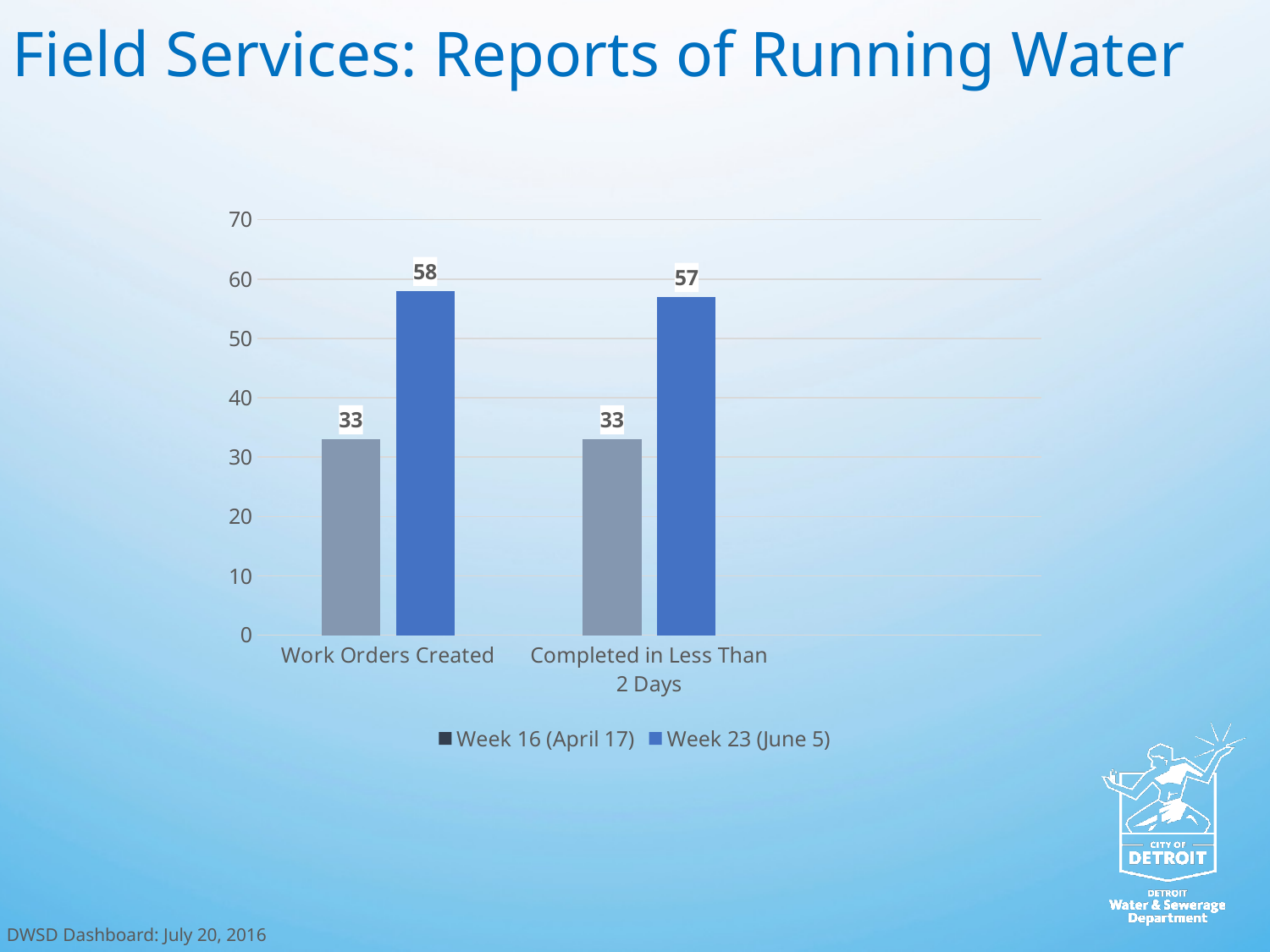
What is the value for Work Orders Created in Week 16 (April 17)? 33 Which series has the higher value for Work Orders Created, Week 16 (April 17) or Week 23 (June 5)? Week 23 (June 5) How many series does the legend list? 2 What is the value for Work Orders Created in Week 23 (June 5)? 58 What is the title of the slide? Field Services: Reports of Running Water What is the difference between the Week 23 (June 5) and Week 16 (April 17) values for Completed in Less Than 2 Days? 24 What is the difference between the Week 23 (June 5) and Week 16 (April 17) values for Work Orders Created? 25 What is the value for Completed in Less Than 2 Days in Week 23 (June 5)? 57 What kind of chart is shown on the slide? Bar chart How many categories are shown on the x axis? 2 What is the value for Completed in Less Than 2 Days in Week 16 (April 17)? 33 Is the Week 23 (June 5) value for Completed in Less Than 2 Days greater or less than 50? greater